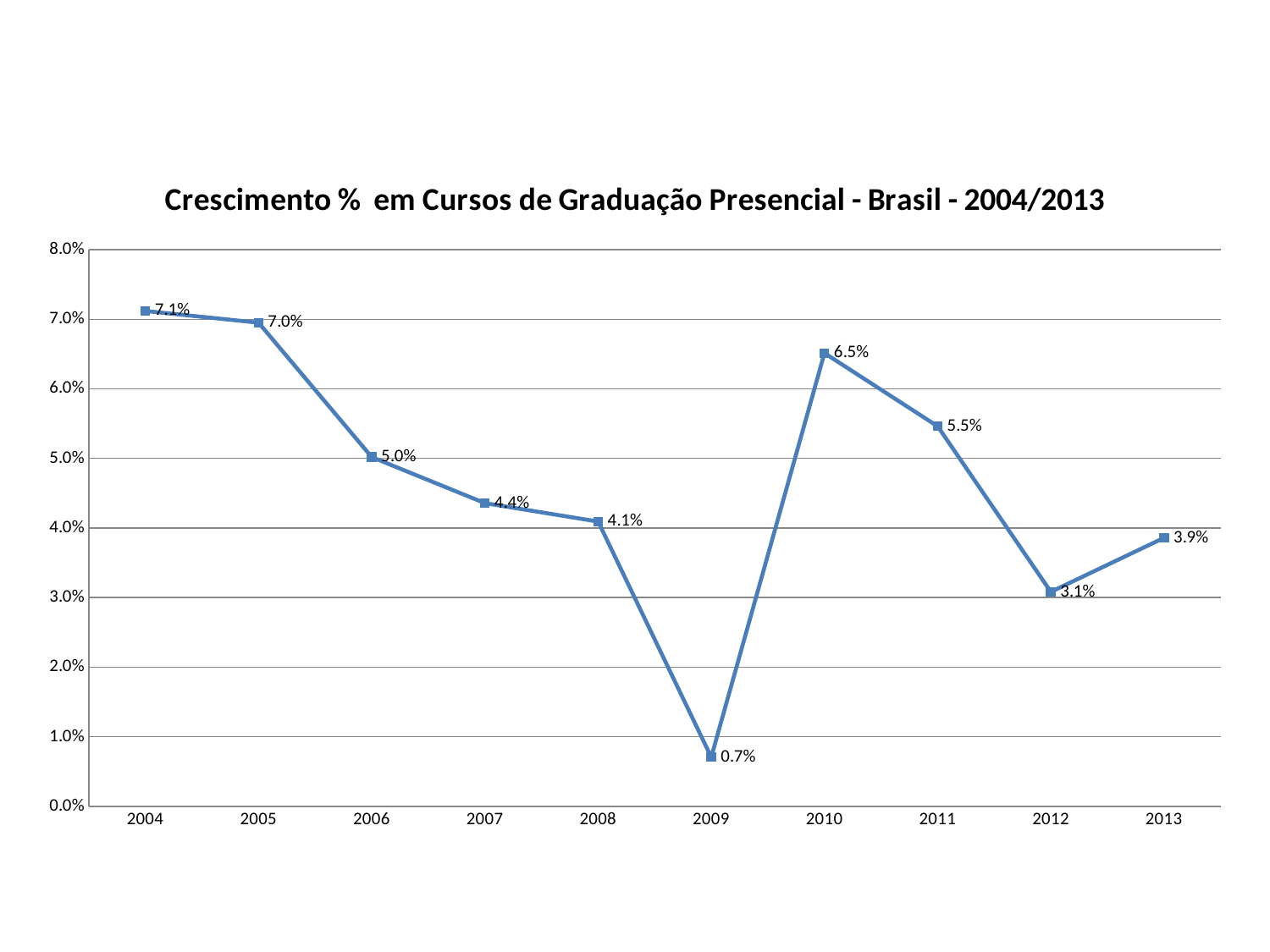
Which year has a larger growth value, 2011 or 2012? 2011 What kind of chart is shown on the slide? Line chart What is the title of the chart? Crescimento % em Cursos de Graduação Presencial - Brasil - 2004/2013 What is the growth value for 2010? 6.5% What is the growth value for 2013? 3.9% What is the growth value for 2009? 0.7% Which year has the lowest growth value? 2009 How many years are plotted on the chart? 10 What is the difference between the growth values for 2010 and 2009? 5.8% Do the values rise or fall from 2004 to 2008? Fall Which year has the highest growth value? 2004 Is the value for 2008 greater or less than 4.0%? greater